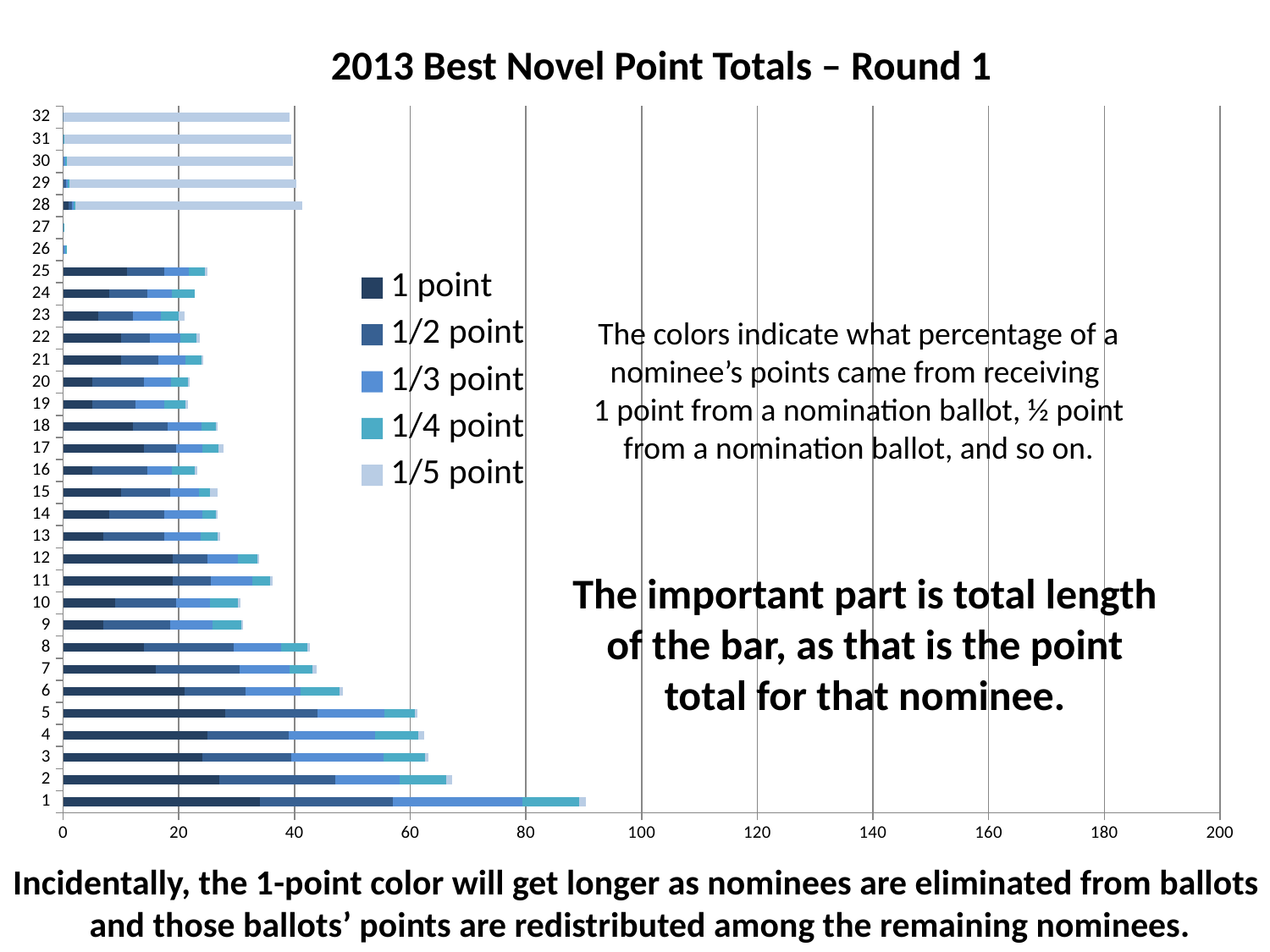
Is the total bar length for nominee 25 greater or less than 20? greater How many series does the legend list? 5 Which nominee has the longest bar (highest point total)? 1 How many nominees (categories) are shown on the y axis? 32 Is the total bar length for nominee 1 greater or less than 80? greater Is the total bar length for nominee 2 greater or less than 60? greater What kind of chart is shown on the slide? bar chart Which has the longer bar, nominee 11 or nominee 23? nominee 11 What is the title of the chart? 2013 Best Novel Point Totals – Round 1 Which has the longer bar, nominee 1 or nominee 2? nominee 1